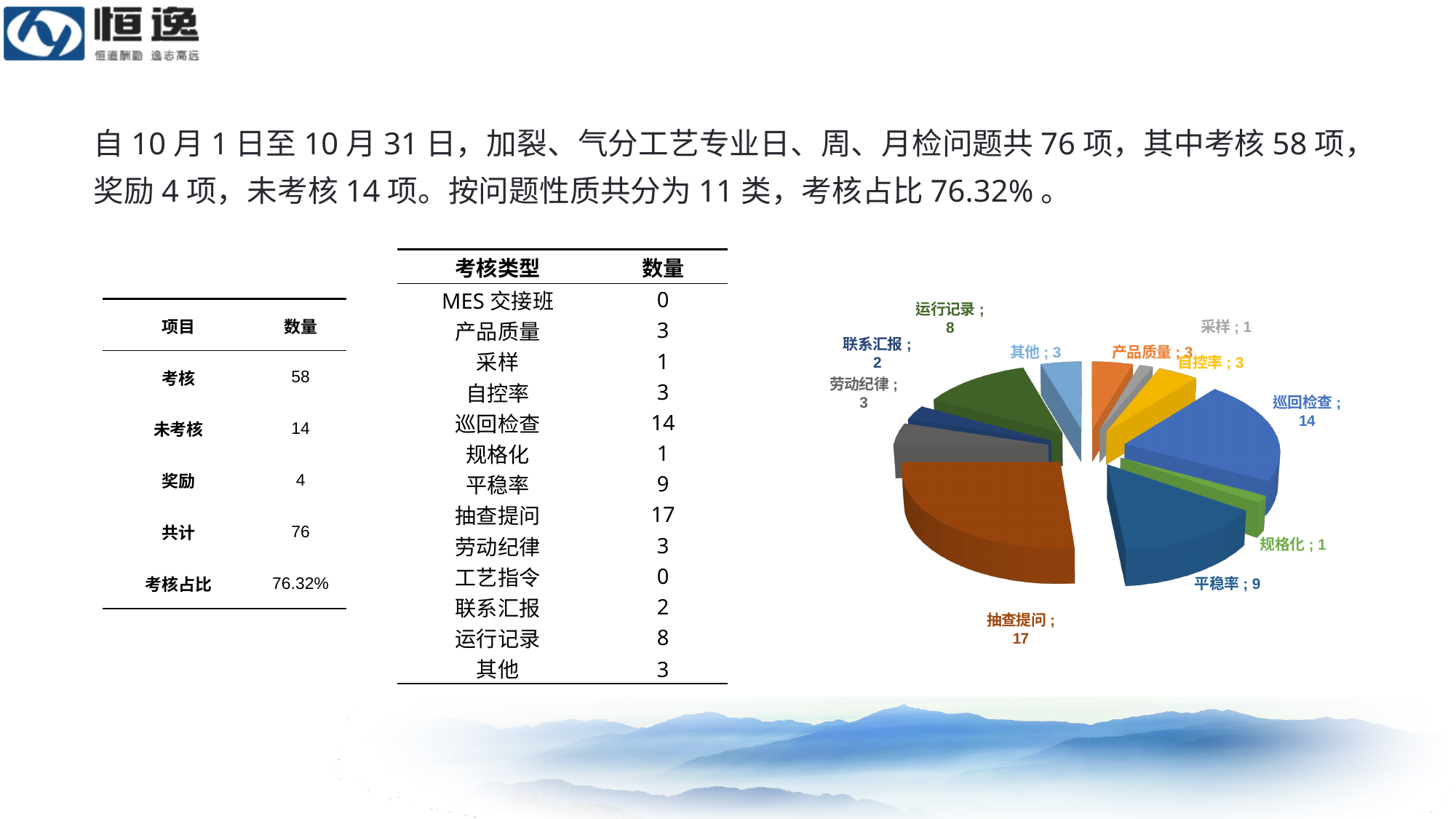
How many labeled slices does the pie chart have? 11 What is the value for 平稳率 in the pie chart? 9 What is the value for 运行记录 in the pie chart? 8 What colour is the 抽查提问 slice in the pie chart? brown Which category has the largest slice in the pie chart? 抽查提问 Which is larger in the pie chart, 巡回检查 or 平稳率? 巡回检查 What is the value for 巡回检查 in the pie chart? 14 What is the difference between the values for 抽查提问 and 巡回检查 in the pie chart? 3 What is the difference between the values for 平稳率 and 运行记录 in the pie chart? 1 What is the value for 联系汇报 in the pie chart? 2 What is the value for 抽查提问 in the pie chart? 17 What kind of chart is shown on the slide? pie chart